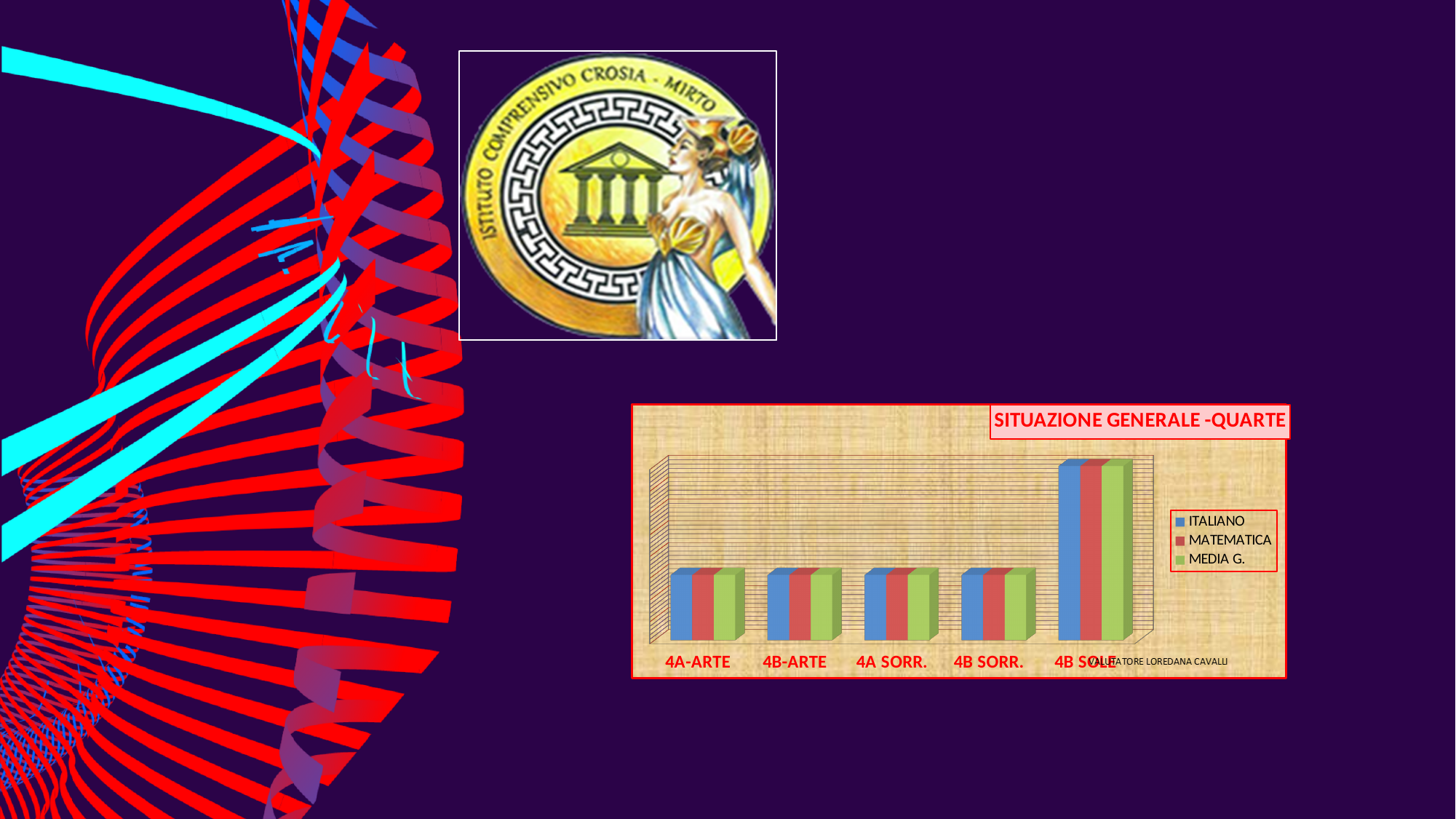
Which is larger, the ITALIANO value for 4B SOLE or the ITALIANO value for 4A-ARTE? 4B SOLE Which is larger, the MATEMATICA value for 4B SORR. or the MATEMATICA value for 4B SOLE? 4B SOLE Which series is shown in green in the legend? MEDIA G. How many categories are shown on the x axis of the chart? 5 What is the title of the chart? SITUAZIONE GENERALE -QUARTE Which category has the highest bars in the chart? 4B SOLE What kind of chart is shown on the slide? Bar chart How many series does the legend list? 3 Which is larger, the MEDIA G. value for 4B SOLE or the MEDIA G. value for 4A SORR.? 4B SOLE